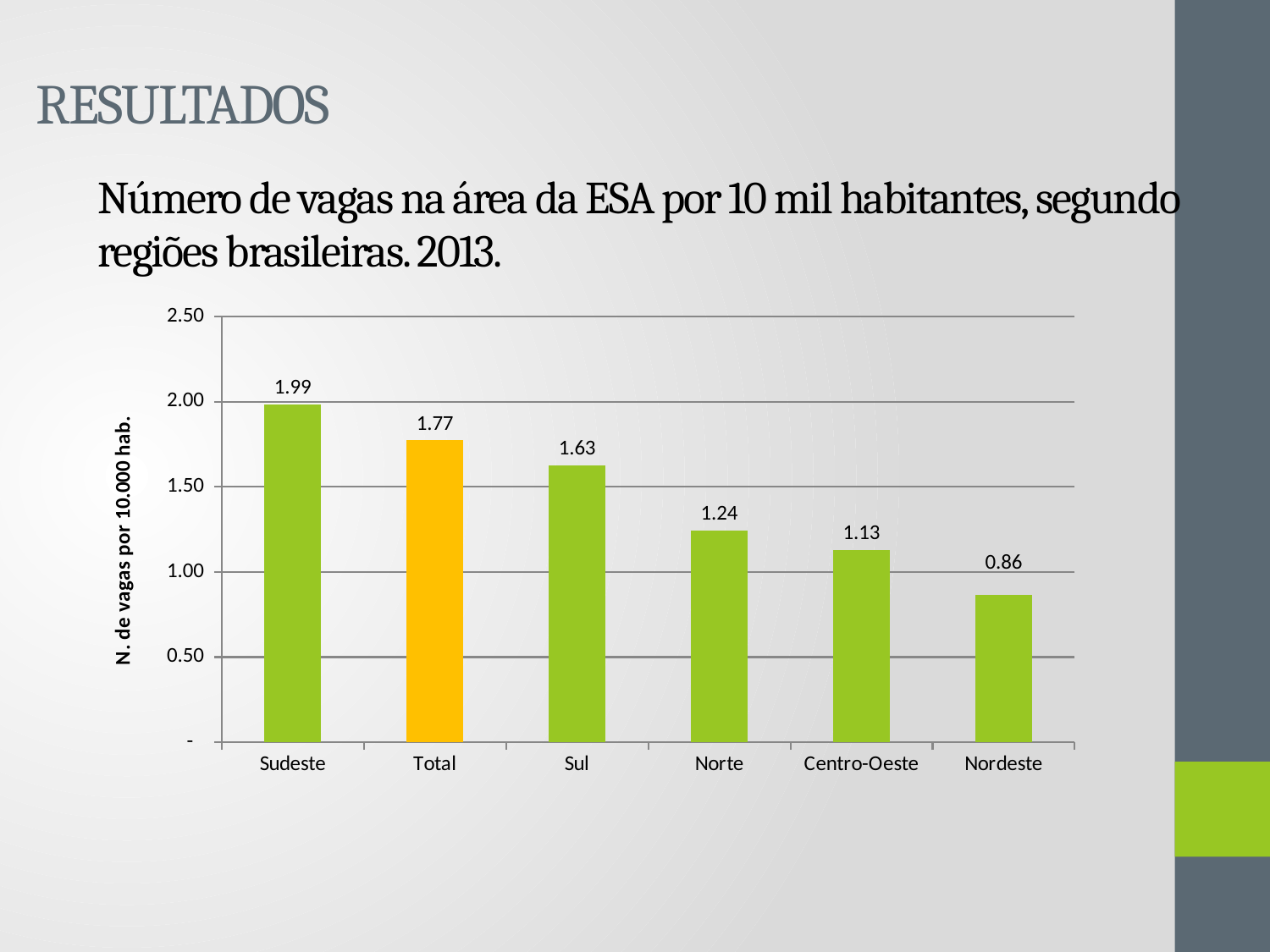
How many categories are shown on the x axis? 6 Which is larger, the value for Norte or the value for Centro-Oeste? Norte What is the value for Nordeste? 0.86 Which category has the lowest value? Nordeste Which category has the highest value? Sudeste What kind of chart is shown? bar chart What is the value for Sudeste? 1.99 What is the value for Norte? 1.24 Is the value for Sul greater or less than 1.50? greater Which bar is coloured differently (yellow) from the others? Total What is the difference between the values for Sudeste and Nordeste? 1.13 What is the difference between the values for Total and Sul? 0.14